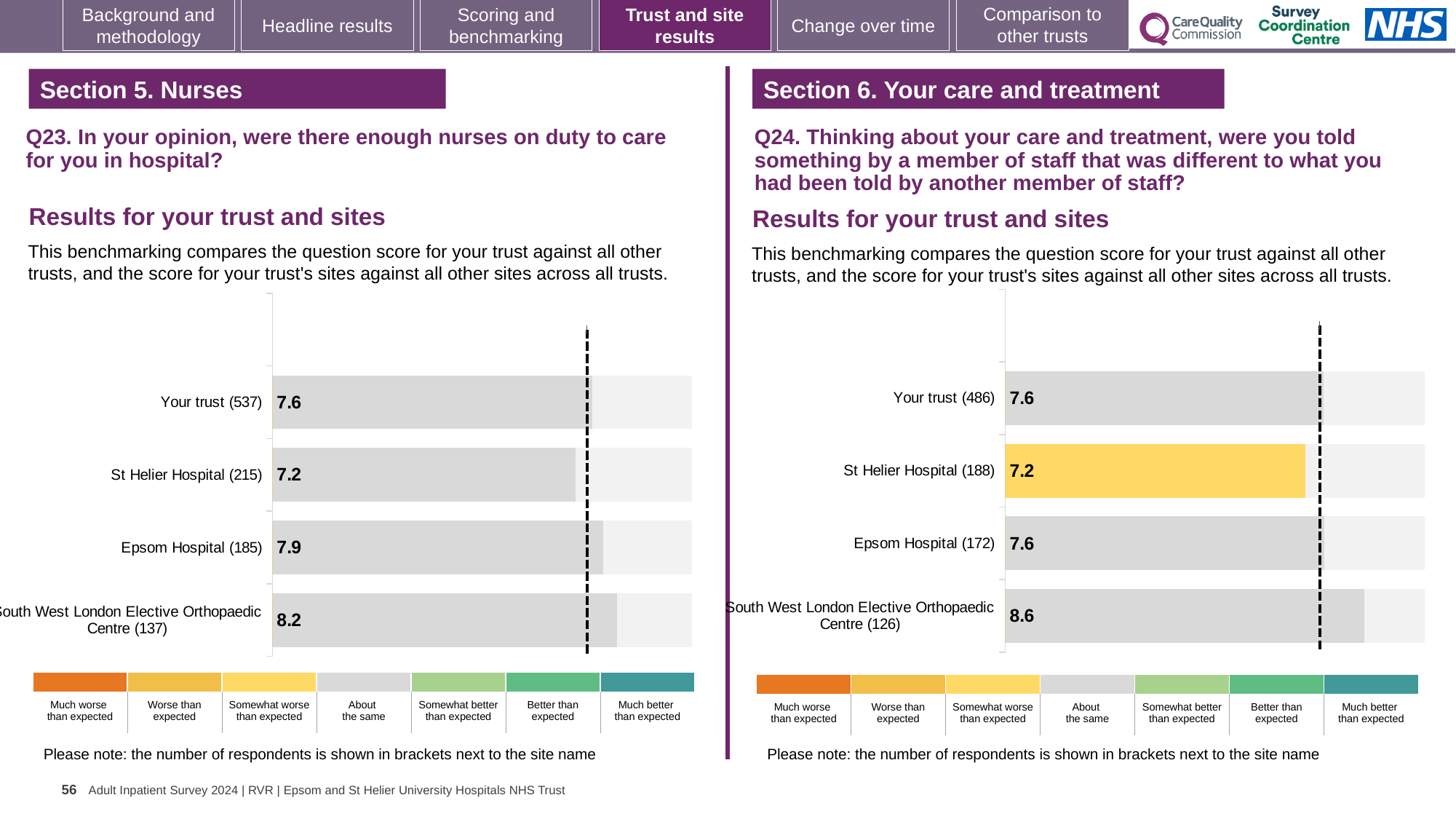
On the Q23 chart (left), how many bars are plotted? 4 On the Q23 chart (left), what is the score for Your trust (537)? 7.6 What type of chart is used on the Q24 chart (right)? bar chart On the Q23 chart (left), which site has the highest score? South West London Elective Orthopaedic Centre (137) On the Q24 chart (right), which site has the lowest score? St Helier Hospital (188) On the Q24 chart (right), what is the score for St Helier Hospital (188)? 7.2 On the Q24 chart (right), is the score for Epsom Hospital larger or smaller than the score for South West London Elective Orthopaedic Centre? smaller On the Q24 chart (right), what is the difference between the scores for Your trust and St Helier Hospital? 0.4 On the Q23 chart (left), what is the score for Epsom Hospital (185)? 7.9 On the Q23 chart (left), which site has the lowest score? St Helier Hospital (215) On the Q23 chart (left), what is the difference between the scores for South West London Elective Orthopaedic Centre and St Helier Hospital? 1.0 On the Q24 chart (right), what is the score for South West London Elective Orthopaedic Centre (126)? 8.6